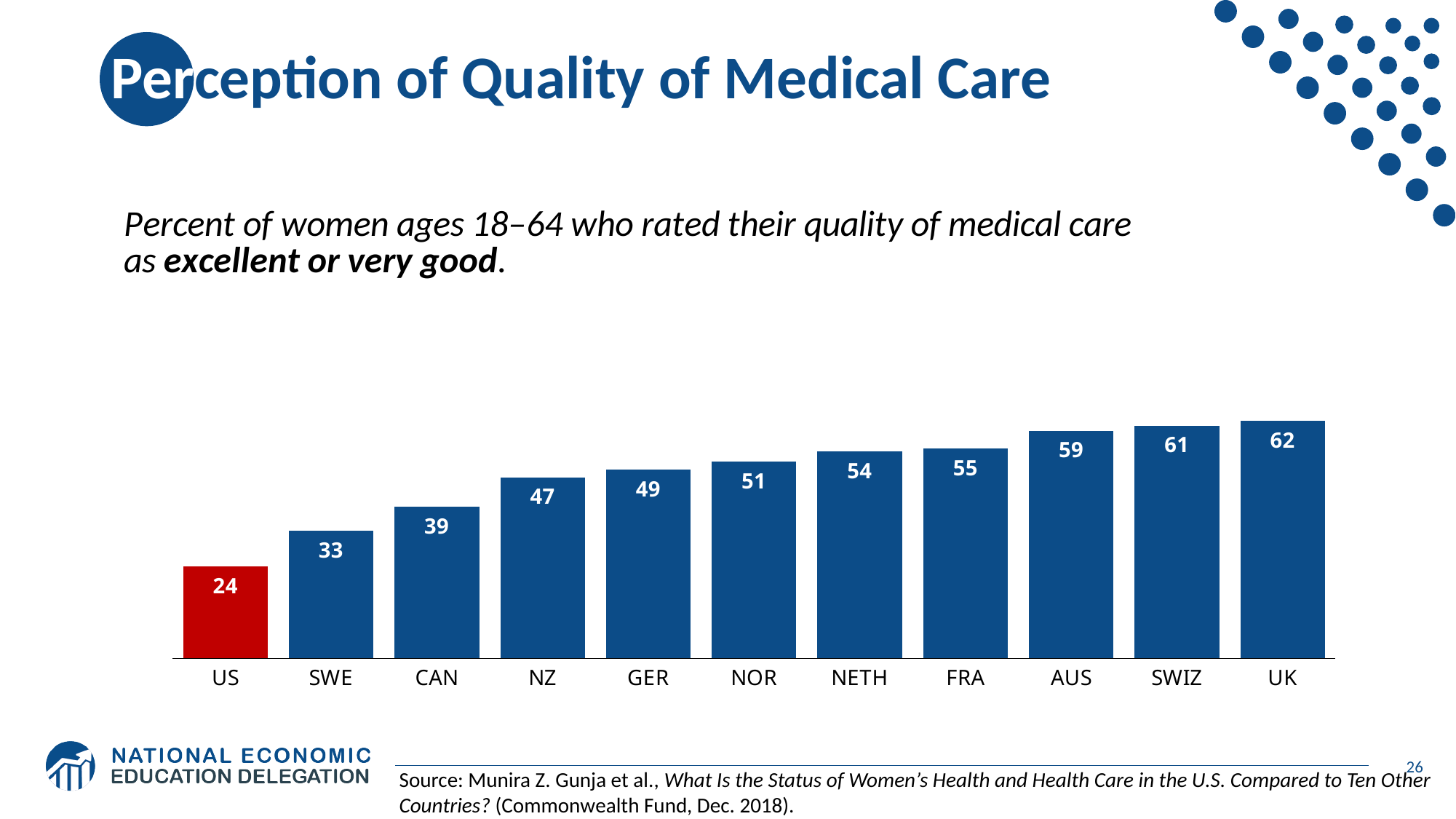
What is the difference between the values for NETH and CAN? 15 What is the value for AUS? 59 What is the value for the US? 24 Which country has the highest value? UK What is the value for GER? 49 How many countries are shown in the chart? 11 What kind of chart is shown on the slide? bar chart Which has a larger value, SWE or NZ? NZ Do the values rise or fall from left to right across the chart? rise Which bar is coloured red rather than blue? US What is the difference between the values for UK and US? 38 Which country has the lowest value? US